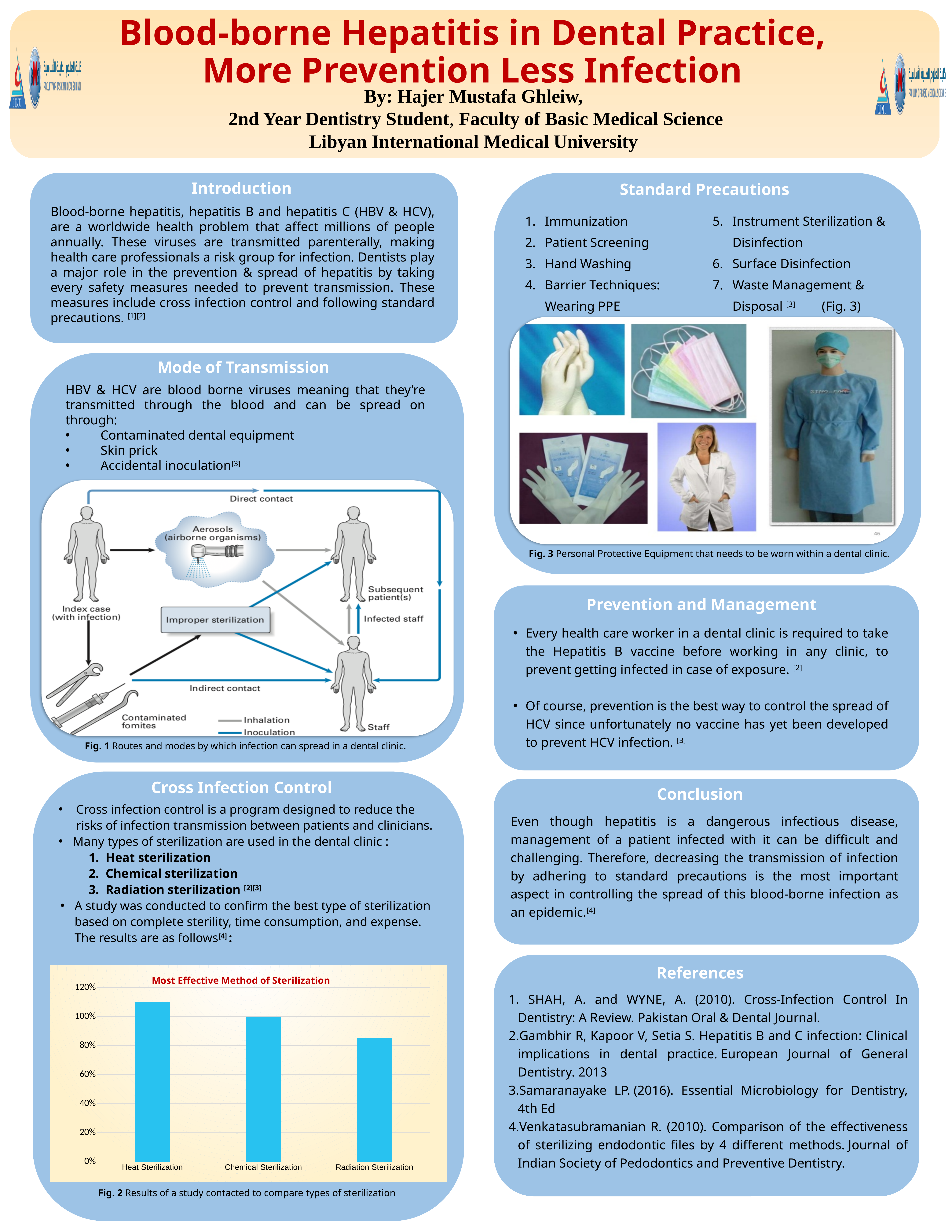
In the Most Effective Method of Sterilization chart, which method has the highest value? Heat Sterilization What kind of chart is shown under the Cross Infection Control section? bar chart In the Most Effective Method of Sterilization chart, is the value for Radiation Sterilization greater or less than 80%? greater What is the title of the chart in the Cross Infection Control section? Most Effective Method of Sterilization In the Most Effective Method of Sterilization chart, do the values rise or fall from left to right across the categories? fall In the Most Effective Method of Sterilization chart, what is the value for Chemical Sterilization? 100% What is the highest value shown on the vertical axis of the Most Effective Method of Sterilization chart? 120% How many sterilization methods are plotted in the Most Effective Method of Sterilization chart? 3 In the Most Effective Method of Sterilization chart, which is larger: Heat Sterilization or Chemical Sterilization? Heat Sterilization In the Most Effective Method of Sterilization chart, is the value for Radiation Sterilization greater or less than 100%? less In the Most Effective Method of Sterilization chart, which method has the lowest value? Radiation Sterilization In the Most Effective Method of Sterilization chart, is the value for Heat Sterilization greater or less than 100%? greater